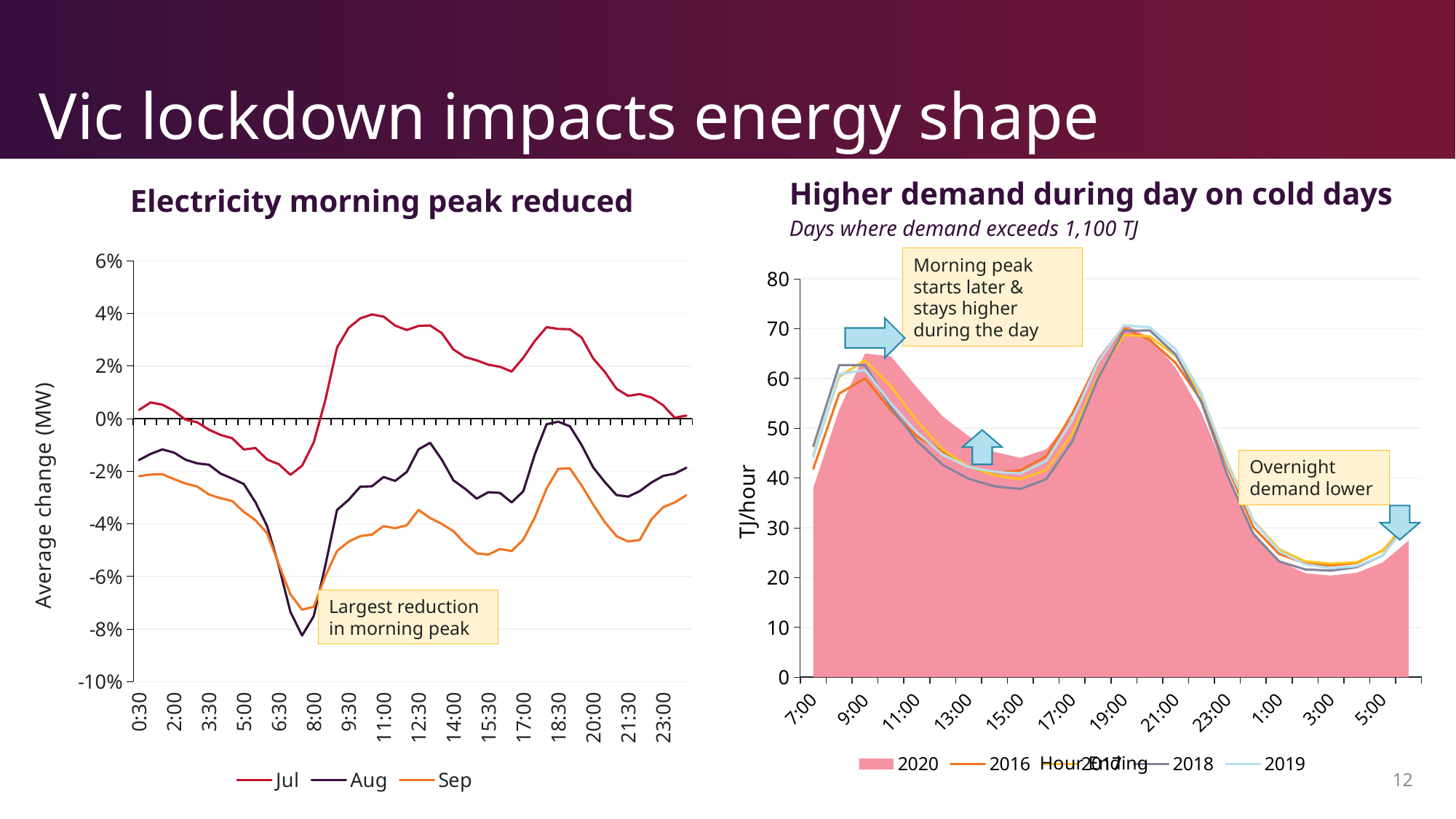
In the 'Higher demand during day on cold days' chart, how many series does the legend list? 5 In the 'Electricity morning peak reduced' chart, which series reaches the lowest value around 7:30? Aug In the 'Higher demand during day on cold days' chart, do the values rise or fall between 21:00 and 1:00? fall In the 'Higher demand during day on cold days' chart, which series is drawn as a shaded area rather than a line? 2020 In the 'Electricity morning peak reduced' chart, is the Jul value at 11:00 greater or less than 2%? greater In the 'Electricity morning peak reduced' chart, which series reaches the highest value overall? Jul In the 'Electricity morning peak reduced' chart, does the Jul line rise or fall between 8:00 and 9:30? rises In the 'Higher demand during day on cold days' chart, is the 2020 value at 19:00 greater or less than 60? greater In the 'Electricity morning peak reduced' chart, is the lowest Aug value greater or less than -6%? less In the 'Electricity morning peak reduced' chart, how many series does the legend list? 3 What kind of chart is the 'Electricity morning peak reduced' chart? line chart